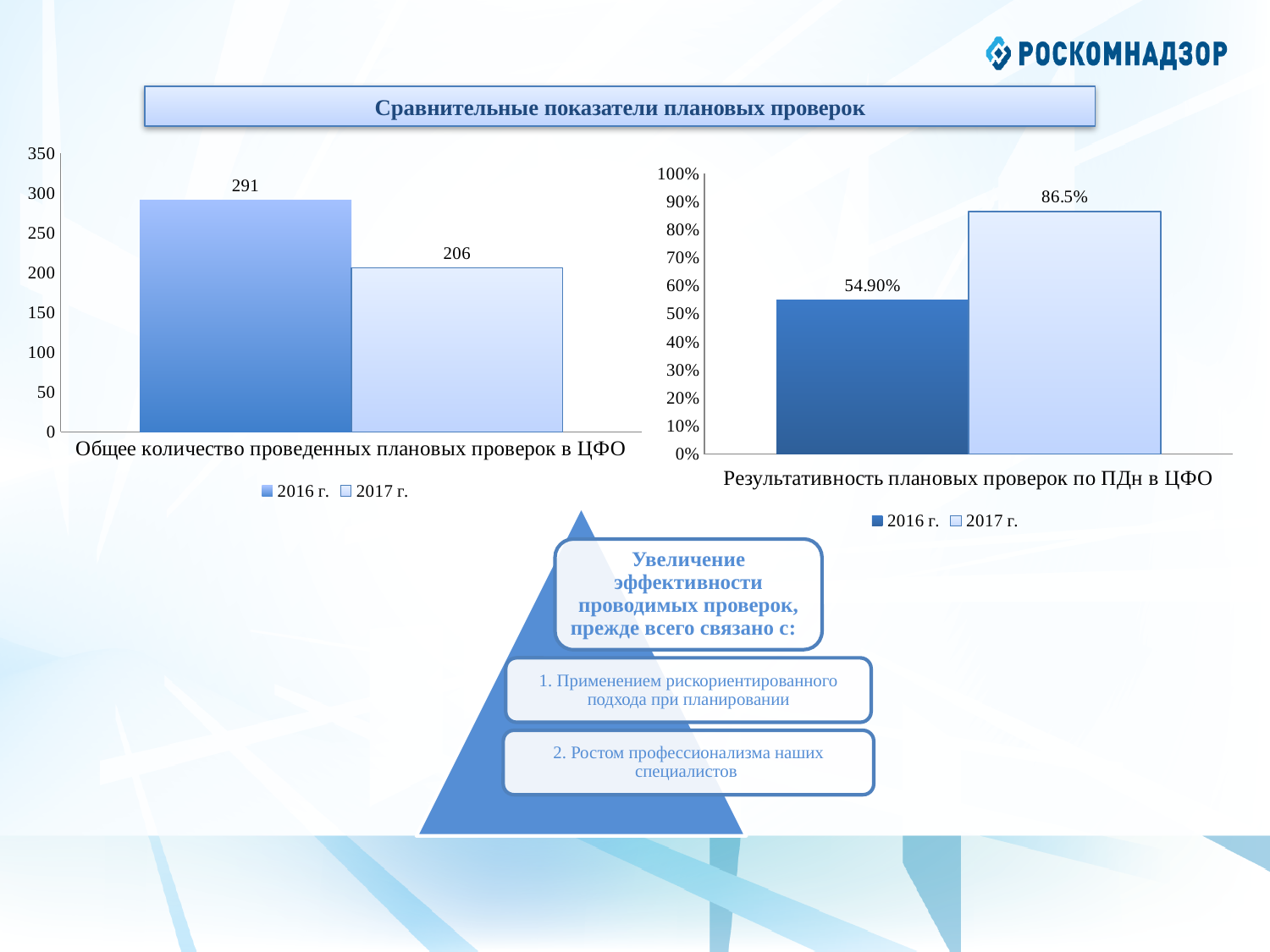
What kind of chart is the right chart (Результативность плановых проверок по ПДн в ЦФО)? bar chart In the right chart (Результативность плановых проверок по ПДн в ЦФО), is the value for 2017 г. greater or less than 80%? greater In the right chart (Результативность плановых проверок по ПДн в ЦФО), what is the value for 2017 г.? 86.5% In the left chart (Общее количество проведенных плановых проверок в ЦФО), which year has the higher value? 2016 г. What is the title shown above both charts on the slide? Сравнительные показатели плановых проверок In the left chart (Общее количество проведенных плановых проверок в ЦФО), what is the difference between the 2016 г. and 2017 г. values? 85 In the right chart (Результативность плановых проверок по ПДн в ЦФО), what is the value for 2016 г.? 54.90% In the left chart (Общее количество проведенных плановых проверок в ЦФО), what is the value for 2017 г.? 206 In the right chart (Результативность плановых проверок по ПДн в ЦФО), which year has the lower value? 2016 г. In the left chart (Общее количество проведенных плановых проверок в ЦФО), what is the value for 2016 г.? 291 In the right chart (Результативность плановых проверок по ПДн в ЦФО), do the values rise or fall from 2016 г. to 2017 г.? rise In the left chart (Общее количество проведенных плановых проверок в ЦФО), how many series does the legend list? 2